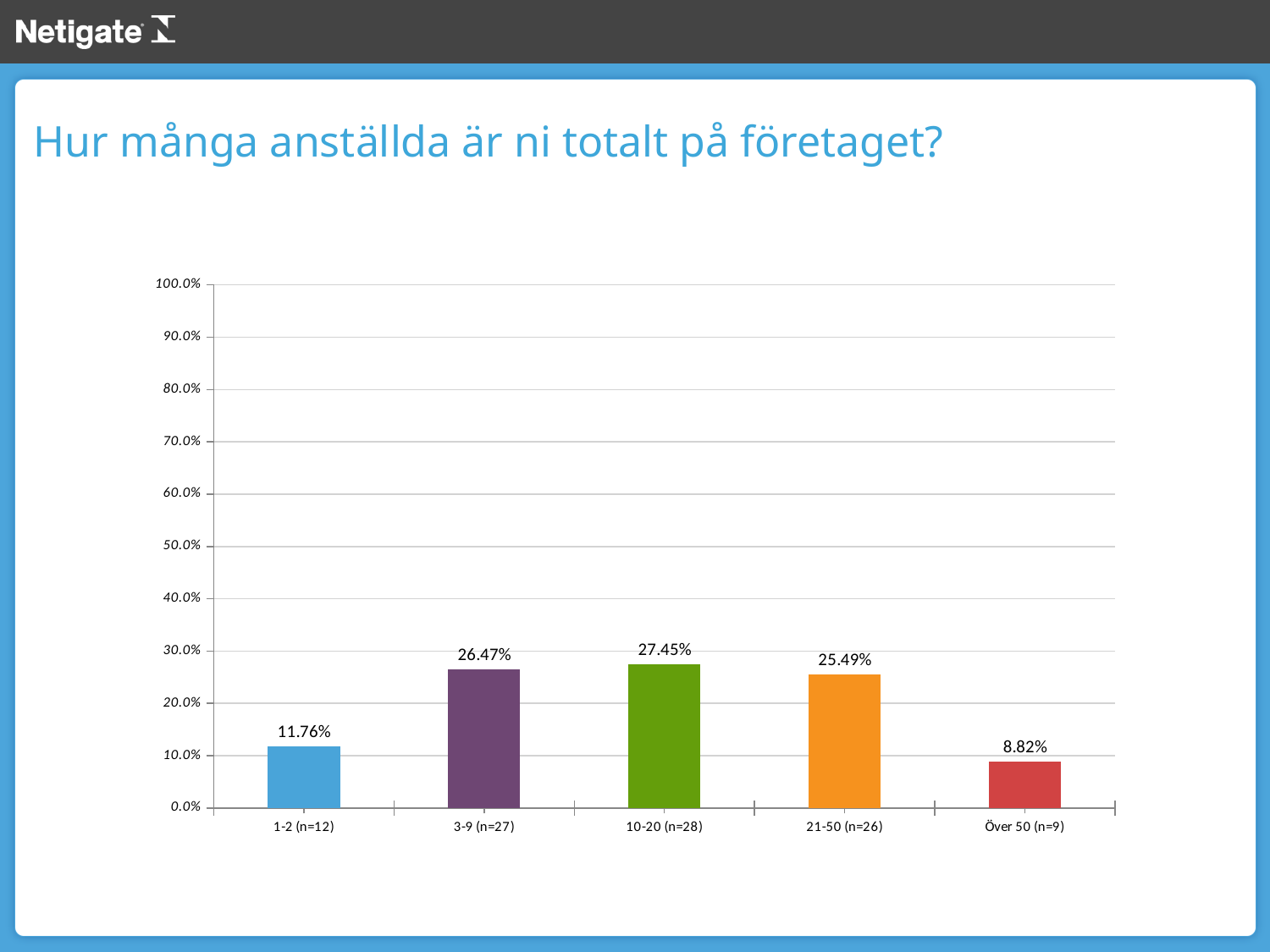
Which category has the highest value? 10-20 (n=28) Is the value for 21-50 (n=26) greater or less than 30.0%? less What is the title of the slide above the chart? Hur många anställda är ni totalt på företaget? What is the value for the 10-20 (n=28) category? 27.45% Which category has the lowest value? Över 50 (n=9) What is the value for the 1-2 (n=12) category? 11.76% What is the value for the 3-9 (n=27) category? 26.47% What kind of chart is shown on the slide? bar chart What is the value for the Över 50 (n=9) category? 8.82% Which is larger, the value for 1-2 (n=12) or the value for Över 50 (n=9)? 1-2 (n=12) What is the difference between the values for 10-20 (n=28) and 21-50 (n=26)? 1.96% How many categories are shown on the x axis? 5